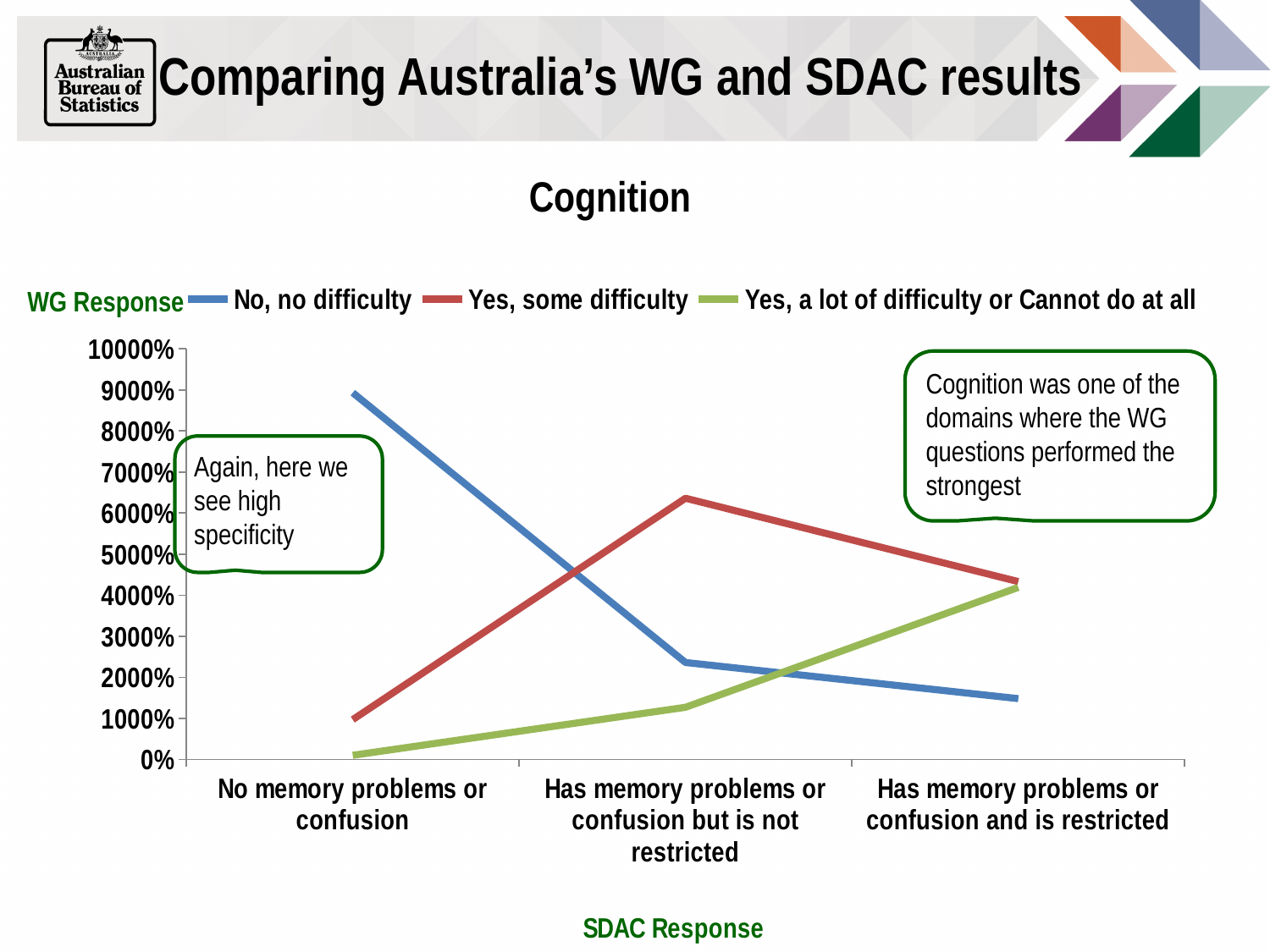
Is the value for 'No, no difficulty' at 'Has memory problems or confusion and is restricted' greater or less than 2000%? less How many SDAC Response categories are shown on the x axis? 3 What kind of chart is shown on the slide? line chart Is the value for 'Yes, a lot of difficulty or Cannot do at all' at 'No memory problems or confusion' greater or less than 1000%? less Which series has the highest value at 'Has memory problems or confusion but is not restricted'? Yes, some difficulty Does the 'No, no difficulty' line rise or fall from left to right along the x axis? fall At 'No memory problems or confusion', which is larger: 'No, no difficulty' or 'Yes, some difficulty'? No, no difficulty Is the value for 'Yes, some difficulty' at 'Has memory problems or confusion but is not restricted' greater or less than 6000%? greater What is the label of the x axis? SDAC Response How many series does the legend list? 3 What is the title of the chart? Cognition